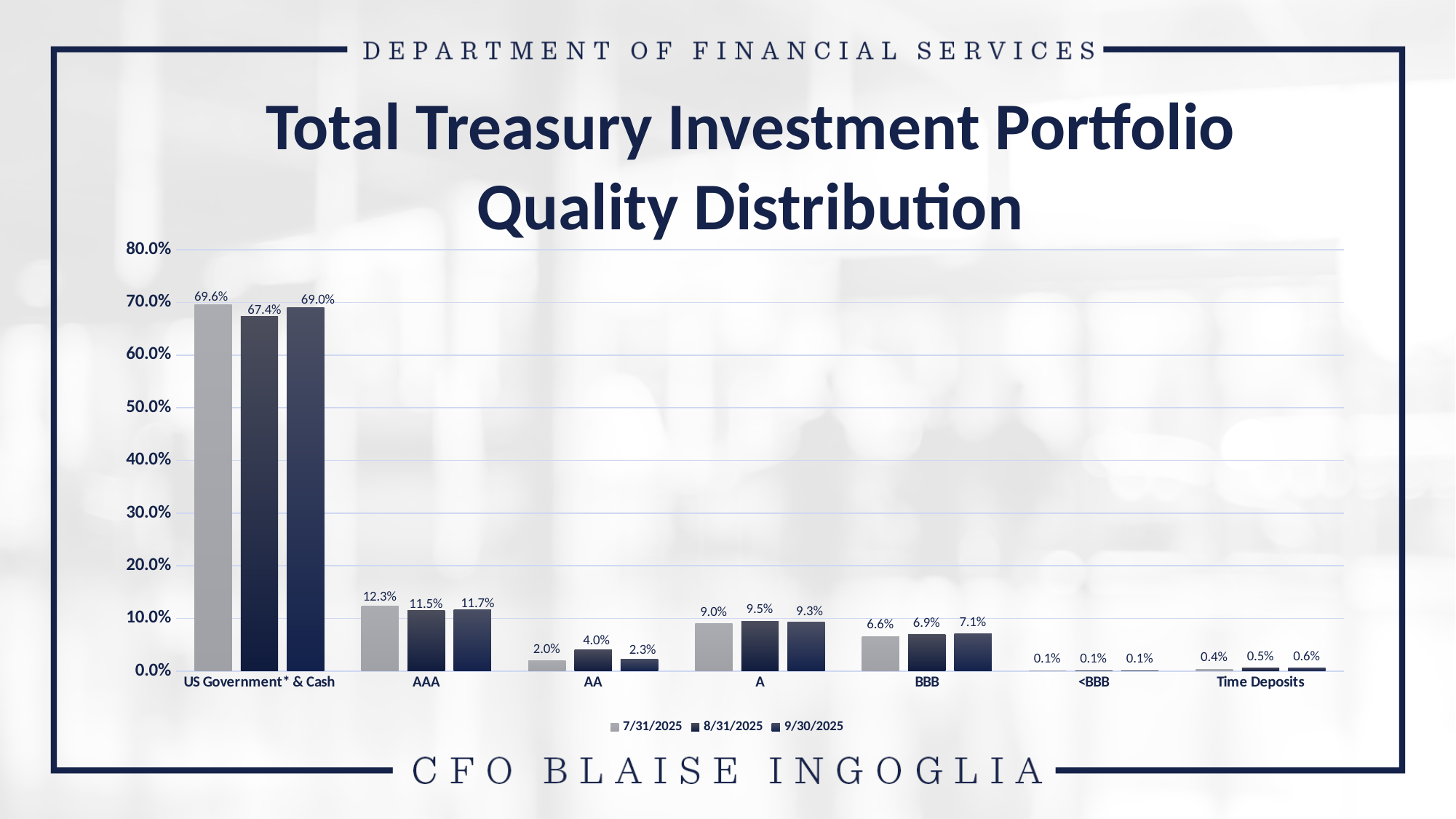
Which is larger for BBB: the 8/31/2025 value or the 9/30/2025 value? 9/30/2025 What is the title of the chart? Total Treasury Investment Portfolio Quality Distribution What is the value for AAA in the 9/30/2025 series? 11.7% Which category has the highest value in the 9/30/2025 series? US Government* & Cash Which category has the lowest value in the 7/31/2025 series? <BBB What kind of chart is shown on the slide? Bar chart How many categories are shown on the x axis? 7 What is the value for Time Deposits in the 9/30/2025 series? 0.6% What is the value for US Government* & Cash in the 7/31/2025 series? 69.6% What is the difference between the 7/31/2025 and 8/31/2025 values for US Government* & Cash? 2.2% How many series does the legend list? 3 What is the value for AA in the 8/31/2025 series? 4.0%